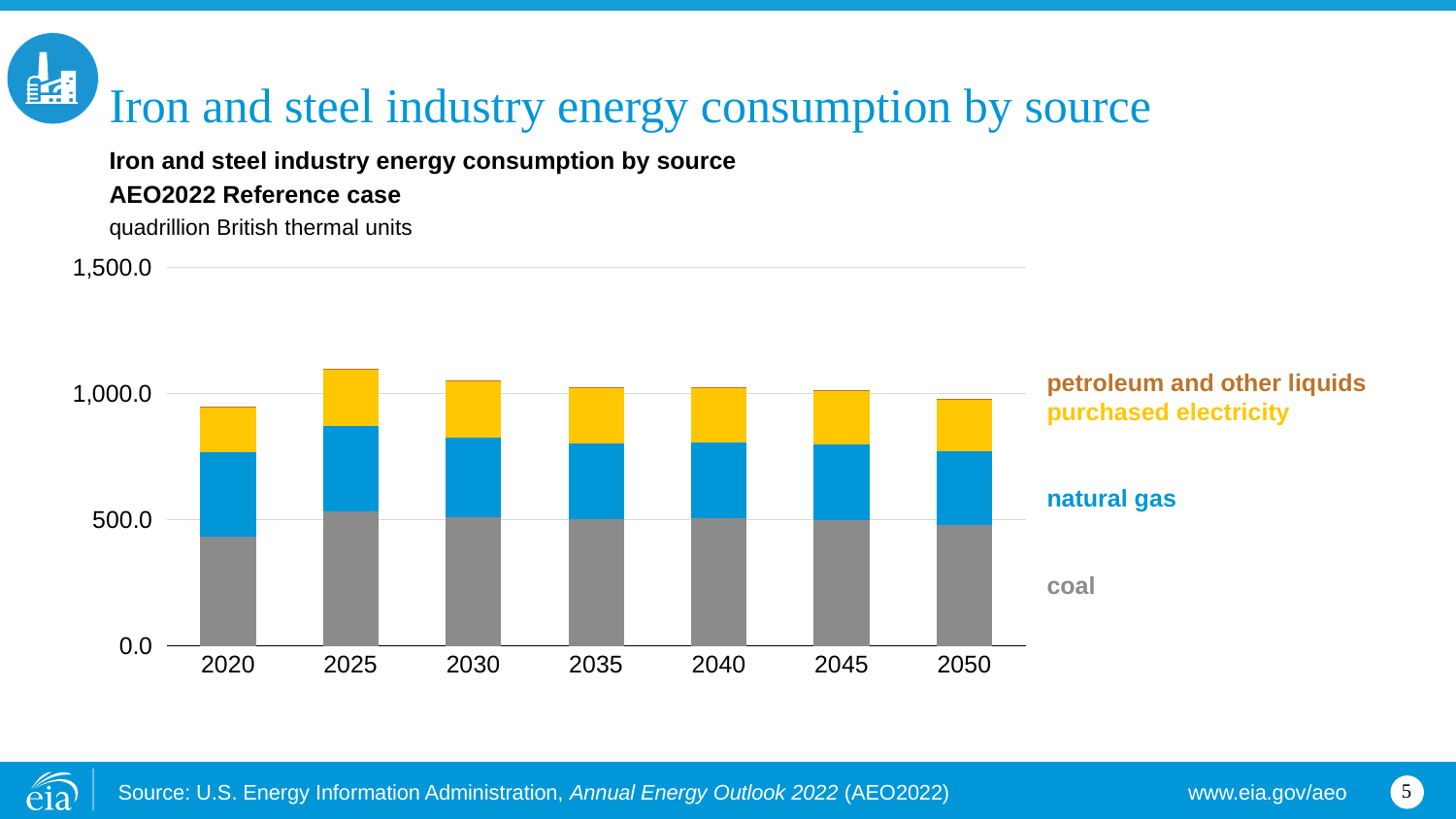
Is the total bar for 2020 greater or less than 1,000.0? less Which year has the smallest coal segment? 2020 What kind of chart is shown on the slide? stacked bar chart How many years are shown on the x axis of the chart? 7 What unit is the chart measured in? quadrillion British thermal units Which year has the tallest total bar? 2025 How many energy sources does the chart's legend list? 4 Do the total bars rise or fall from 2025 to 2050? fall Which energy source is shown at the bottom of each stacked bar? coal Is the coal segment for 2020 greater or less than 500.0? less Which year has the larger total bar, 2020 or 2025? 2025 Is the total bar for 2025 greater or less than 1,000.0? greater